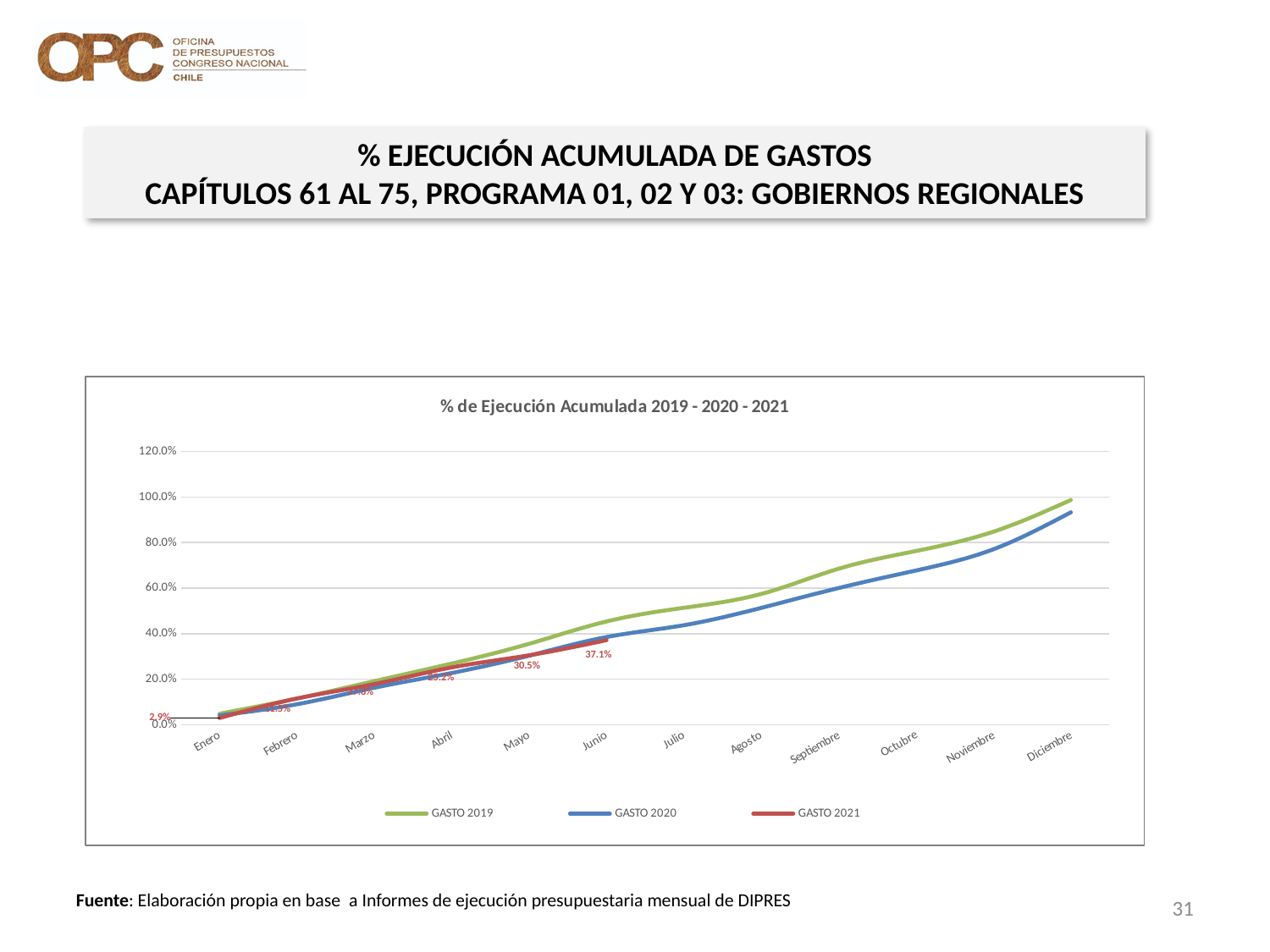
What kind of chart is shown on the slide? line chart How many series does the chart legend list? 3 By how much did GASTO 2021 increase from Mayo to Junio? 6.6% How many months are shown along the x axis of the chart? 12 What is the value of GASTO 2021 in Junio? 37.1% Do the values for GASTO 2019 rise or fall from Enero to Diciembre? rise What is the title of the chart? % de Ejecución Acumulada 2019 - 2020 - 2021 Is the value for GASTO 2020 in Diciembre greater or less than 80%? greater What is the value of GASTO 2021 in Mayo? 30.5% What is the value of GASTO 2021 in Enero? 2.9% In Diciembre, which series is higher, GASTO 2019 or GASTO 2020? GASTO 2019 Is the value for GASTO 2019 in Septiembre greater or less than 60%? greater